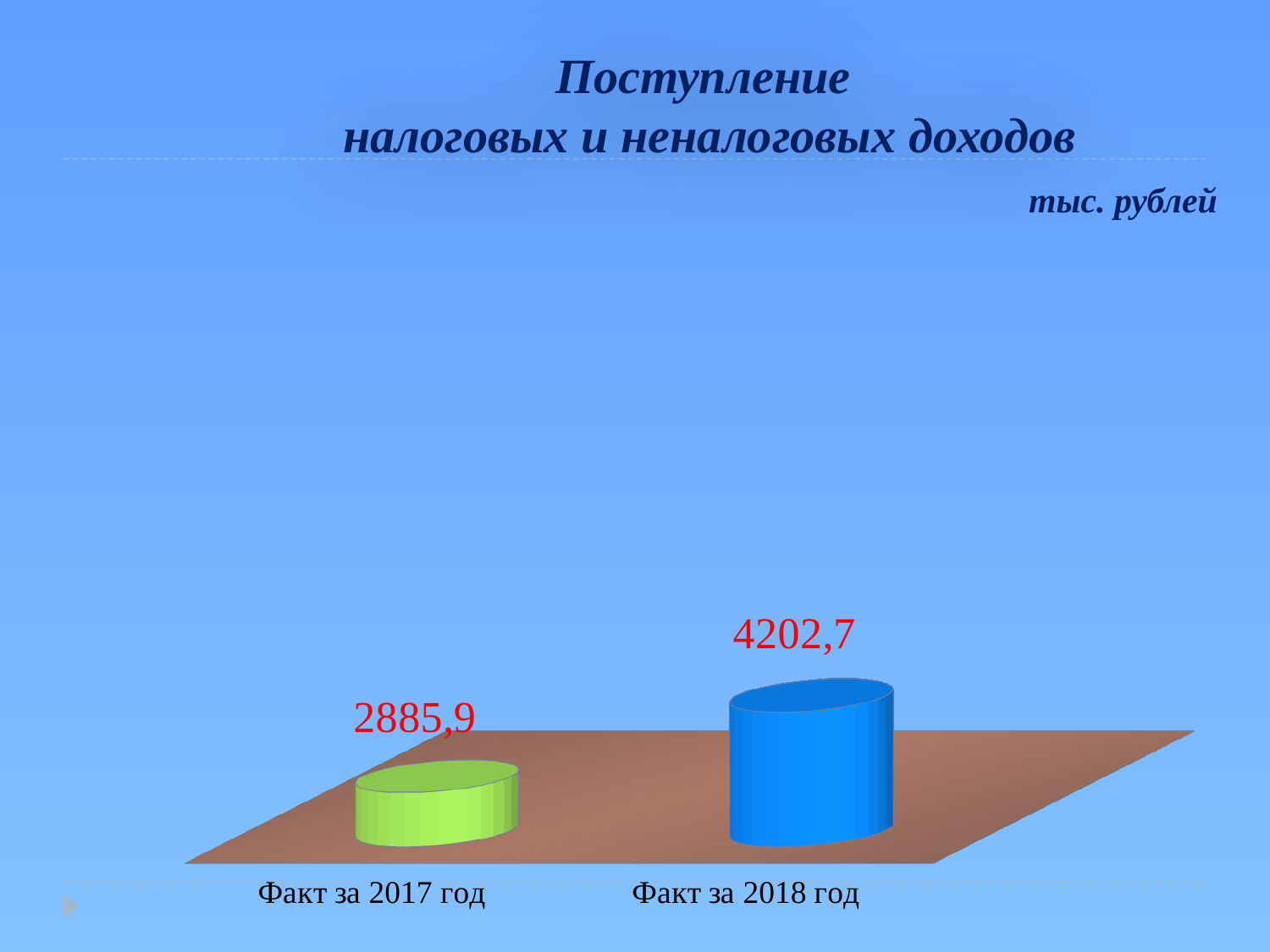
Which category has the highest value? Факт за 2018 год Do the values rise or fall from Факт за 2017 год to Факт за 2018 год? rise Which category has the lowest value? Факт за 2017 год What is the value for Факт за 2017 год? 2885,9 How many categories are shown in the chart? 2 What kind of chart is shown on the slide? bar chart What is the difference between the values for Факт за 2018 год and Факт за 2017 год? 1316,8 What is the value for Факт за 2018 год? 4202,7 Which is larger, the value for Факт за 2017 год or the value for Факт за 2018 год? Факт за 2018 год In what units are the chart values given? тыс. рублей What is the title of the chart? Поступление налоговых и неналоговых доходов